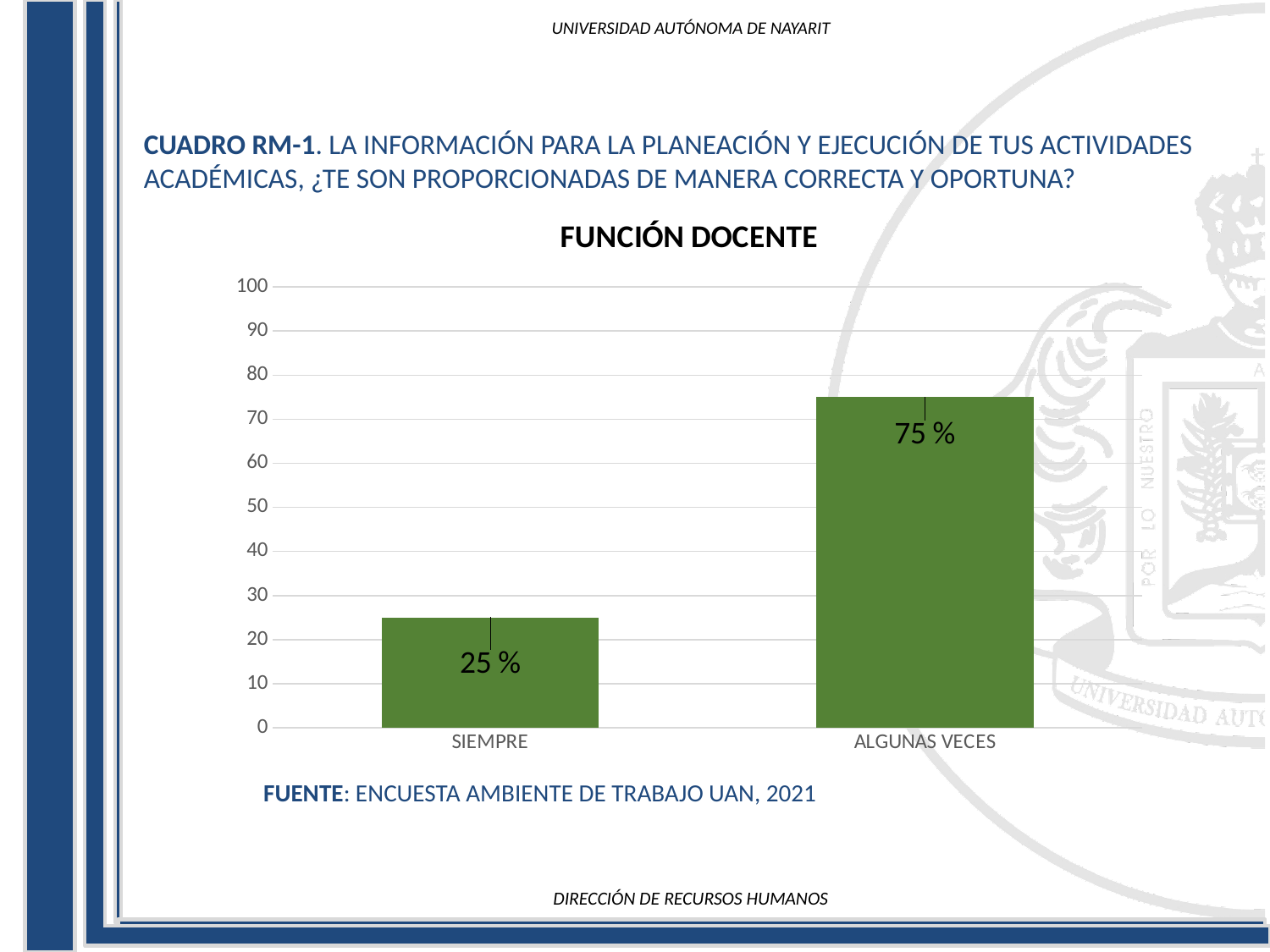
What is the difference between the values for ALGUNAS VECES and SIEMPRE? 50 % Is the value for ALGUNAS VECES greater or less than 50? greater What is the title of the chart? FUNCIÓN DOCENTE What colour are the bars in the chart? green Is the value for SIEMPRE greater or less than 30? less Which is larger, the value for SIEMPRE or the value for ALGUNAS VECES? ALGUNAS VECES What is the value for SIEMPRE? 25 % Which category has the lowest value? SIEMPRE What is the value for ALGUNAS VECES? 75 % What kind of chart is shown on the slide? bar chart How many categories are shown on the x axis? 2 Which category has the highest value? ALGUNAS VECES